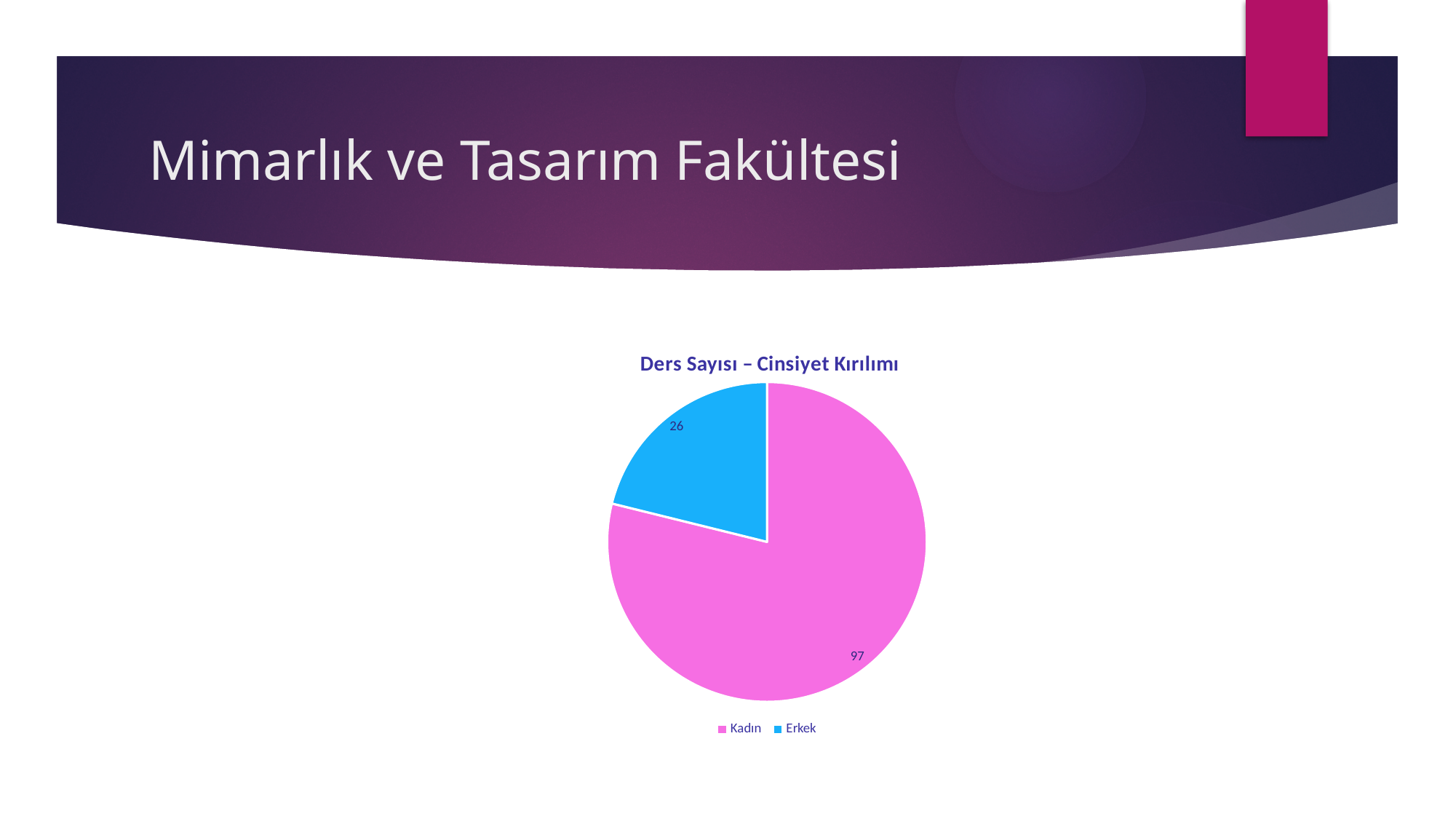
How many slices does the pie chart have? 2 Which category has the largest slice in the pie chart? Kadın Which category has the smallest slice in the pie chart? Erkek What is the value for Kadın in the pie chart? 97 What is the total of the two slices in the pie chart? 123 What is the title of the chart? Ders Sayısı – Cinsiyet Kırılımı What is the difference between the Kadın and Erkek values? 71 Which colour represents Erkek in the pie chart? Blue Which is larger, the value for Kadın or the value for Erkek? Kadın What is the value for Erkek in the pie chart? 26 What kind of chart is shown on the slide? Pie chart